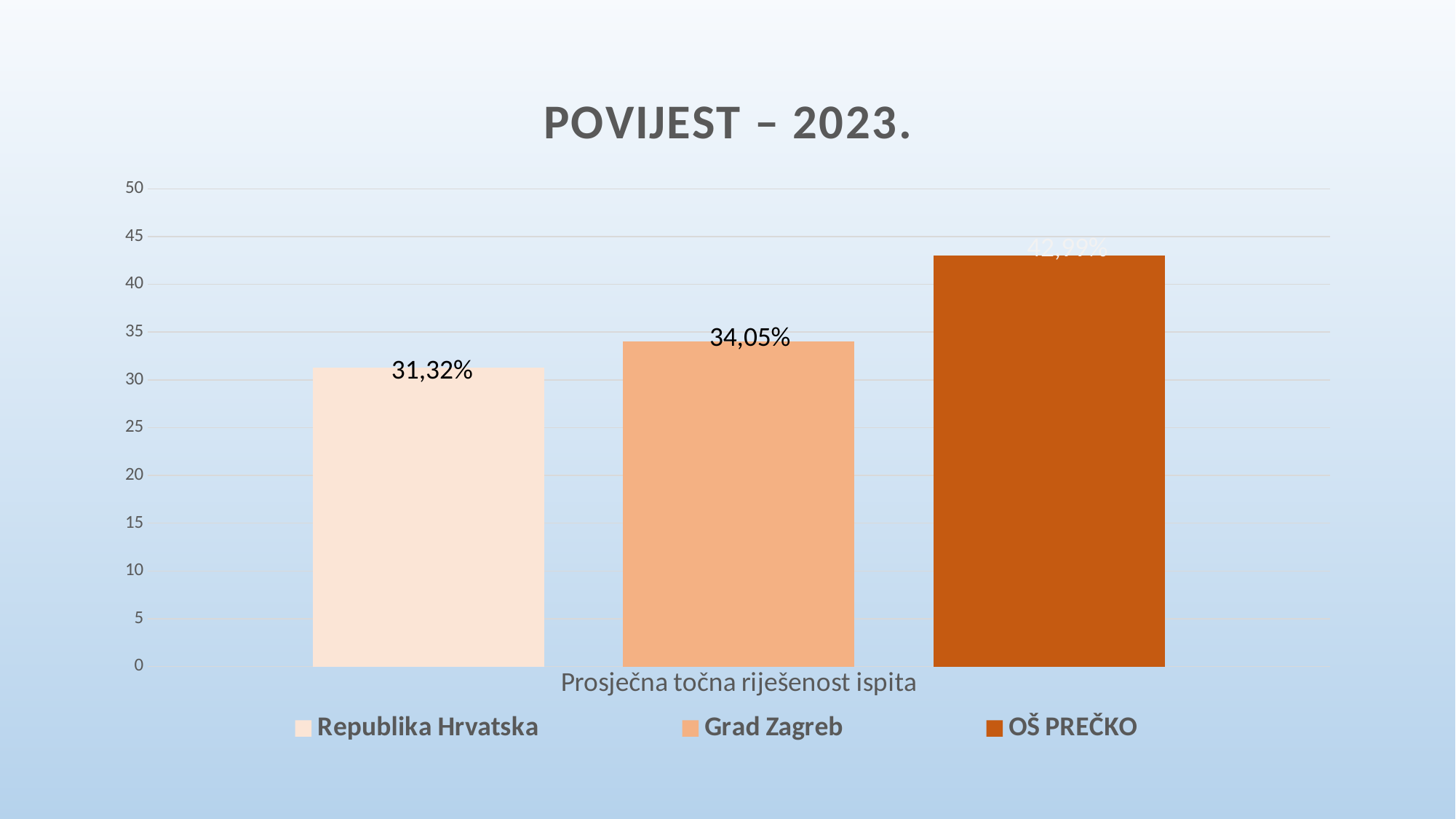
What is the difference between the values for Grad Zagreb and Republika Hrvatska? 2,73% What is the value for Republika Hrvatska? 31,32% Which series has the lowest value? Republika Hrvatska Which is larger, the value for Grad Zagreb or the value for OŠ PREČKO? OŠ PREČKO What is the difference between the values for OŠ PREČKO and Republika Hrvatska? 11,67% How many series does the legend list? 3 Is the value for Grad Zagreb greater or less than 35? less What is the value for OŠ PREČKO? 42,99% What is the value for Grad Zagreb? 34,05% Which series has the highest value? OŠ PREČKO What kind of chart is shown on the slide? bar chart What is the title of the chart? POVIJEST – 2023.